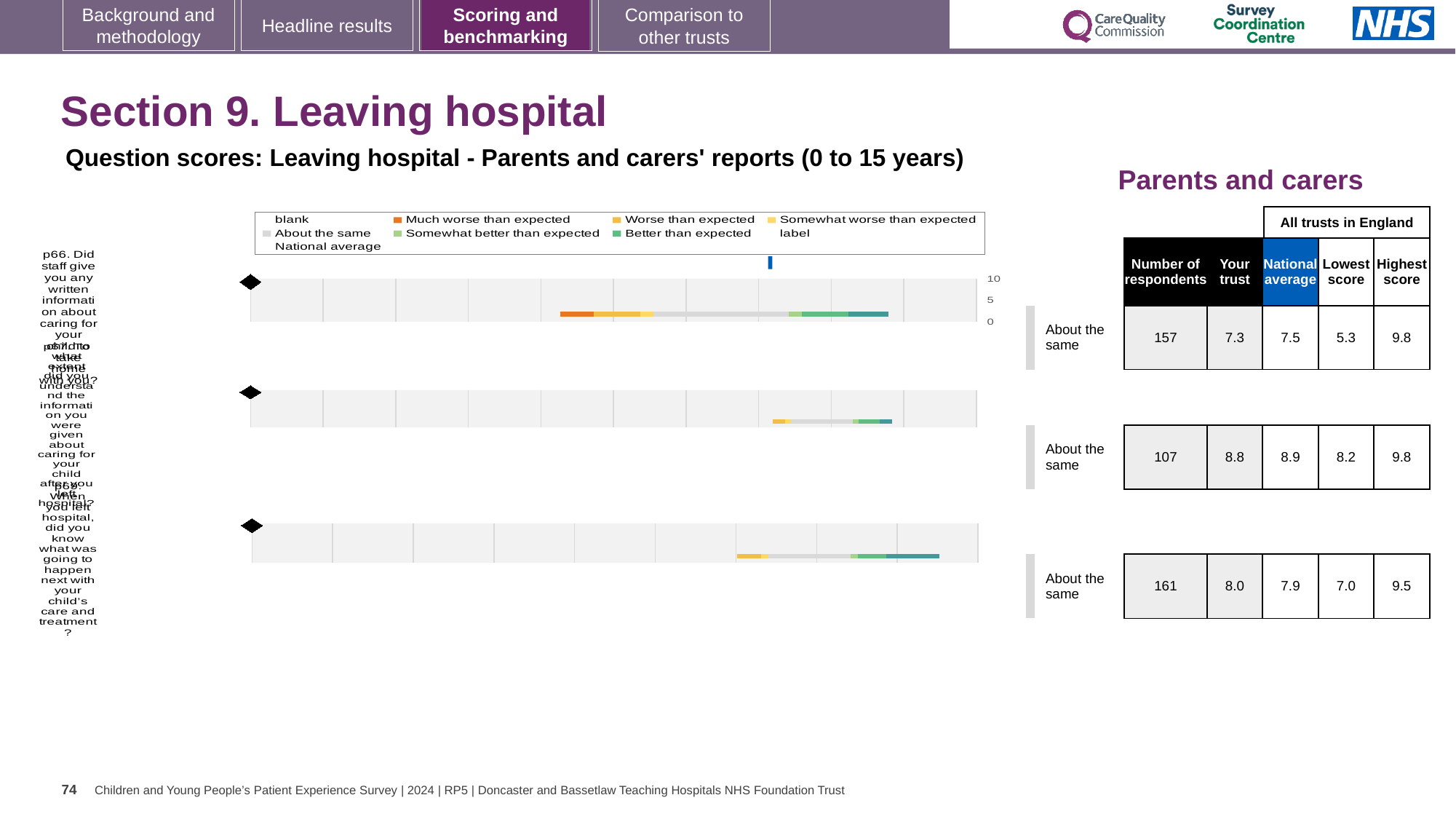
Which legend entry is shown in orange? Much worse than expected How many question bars are plotted in the chart area? 3 For the third question (p68), what is the difference between the highest score and the lowest score across all trusts in England? 2.5 Which of the three questions has the highest 'Your trust' score? the middle question (8.8) What kind of chart is used to show the question scores on this slide? bar chart What is the maximum value shown on the score axis of the charts? 10 In the table beside the charts, how many respondents are listed for the third question (p68, knowing what was going to happen next)? 161 In the table beside the charts, what is the national average for the middle question? 8.9 For the third question (p68), is the 'Your trust' score higher or lower than the national average? higher In the table beside the charts, what is the 'Your trust' score for the first question (p66, written information about caring for your child at home)? 7.3 What benchmark category is shown for all three questions? About the same In the table beside the charts, what is the lowest score across all trusts in England for the third question (p68)? 7.0